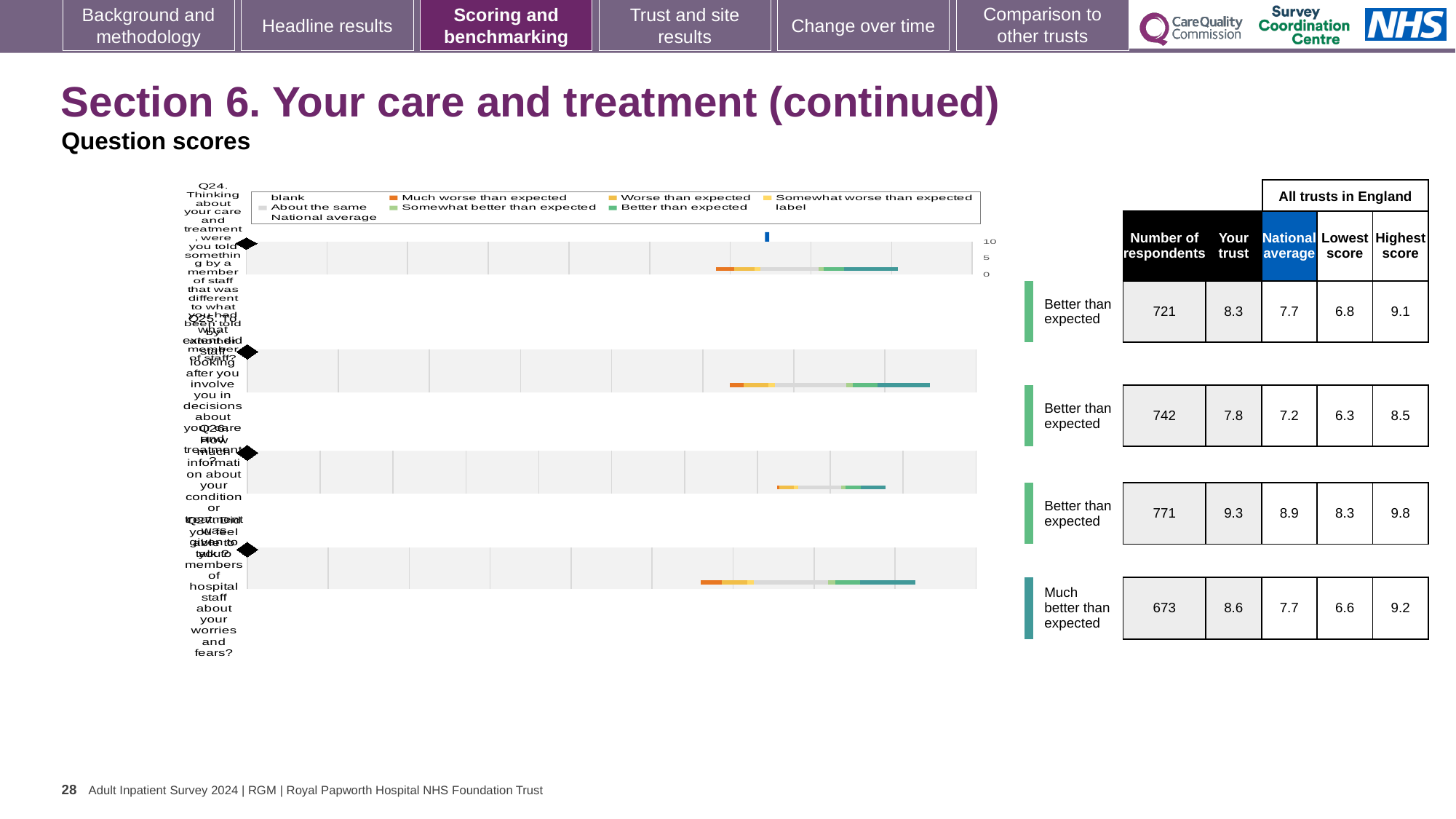
For the first row (Q24), what is the difference between the 'Your trust' score and the national average? 0.6 For the first row (Q24), what is the 'Your trust' score? 8.3 For the fourth row (Q27), what is the lowest score among all trusts in England? 6.6 What benchmark category is shown for the fourth row (Q27)? Much better than expected How many entries does the legend at the top of the charts list? 9 Which question row has the fewest respondents? Q27 (673) How many question rows (charts) are shown on the slide? 4 Which question row has the highest 'Your trust' score? Q26 (9.3) For the first row (Q24), what is the number of respondents shown in the table? 721 What kind of chart is used for each question row on the slide? bar chart For the third row (Q26), what is the highest score among all trusts in England? 9.8 For the second row (Q25), what is the national average score? 7.2